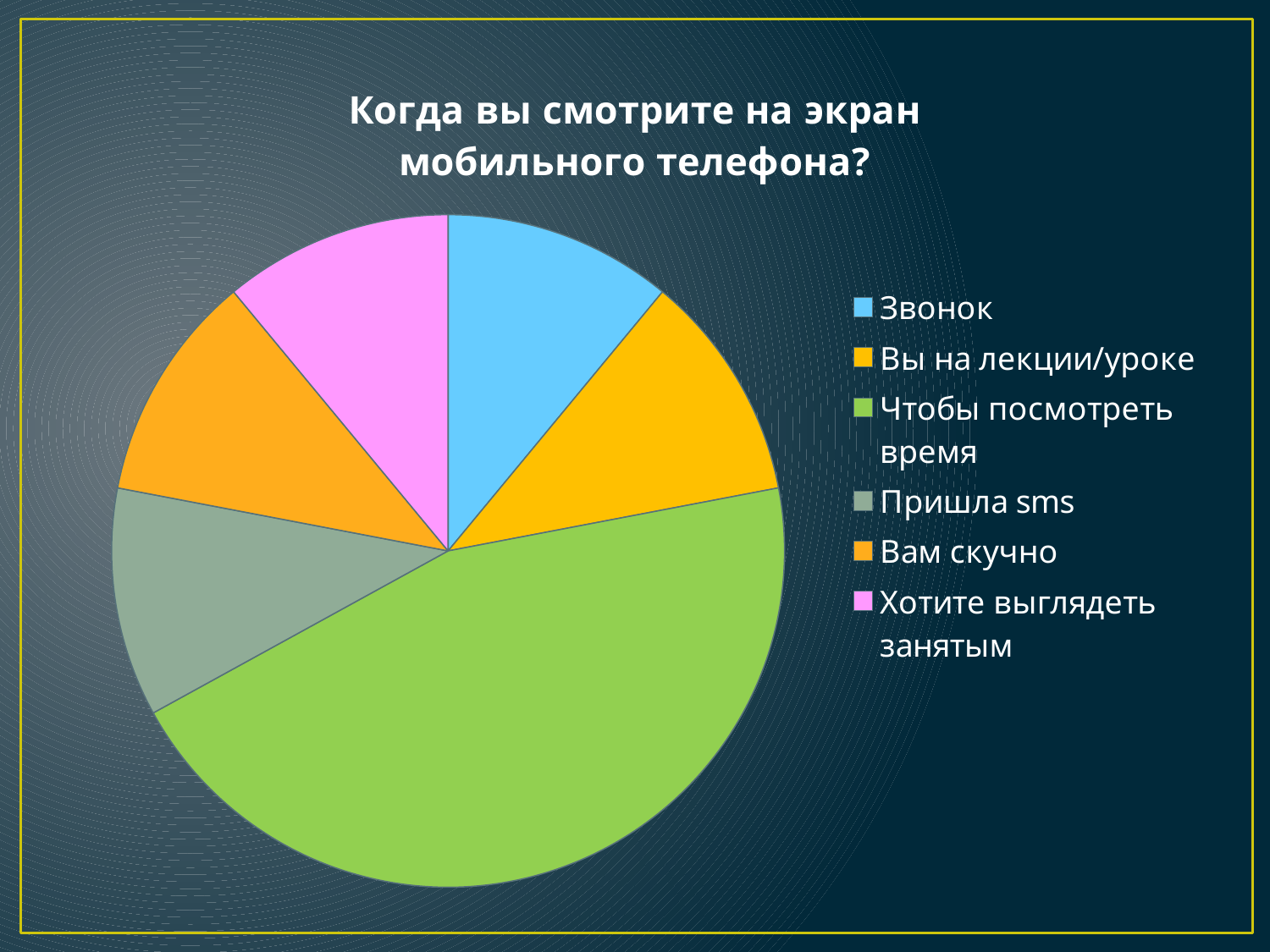
How many categories (slices) does the pie chart have? 6 What colour is the slice for "Чтобы посмотреть время"? Green What kind of chart is shown on the slide? Pie chart Which slice is larger: "Чтобы посмотреть время" or "Пришла sms"? Чтобы посмотреть время What is the title of the chart? Когда вы смотрите на экран мобильного телефона? How many entries does the legend list? 6 Which slice is larger: "Чтобы посмотреть время" or "Хотите выглядеть занятым"? Чтобы посмотреть время Which slice is larger: "Чтобы посмотреть время" or "Звонок"? Чтобы посмотреть время Which category has the largest slice of the pie? Чтобы посмотреть время